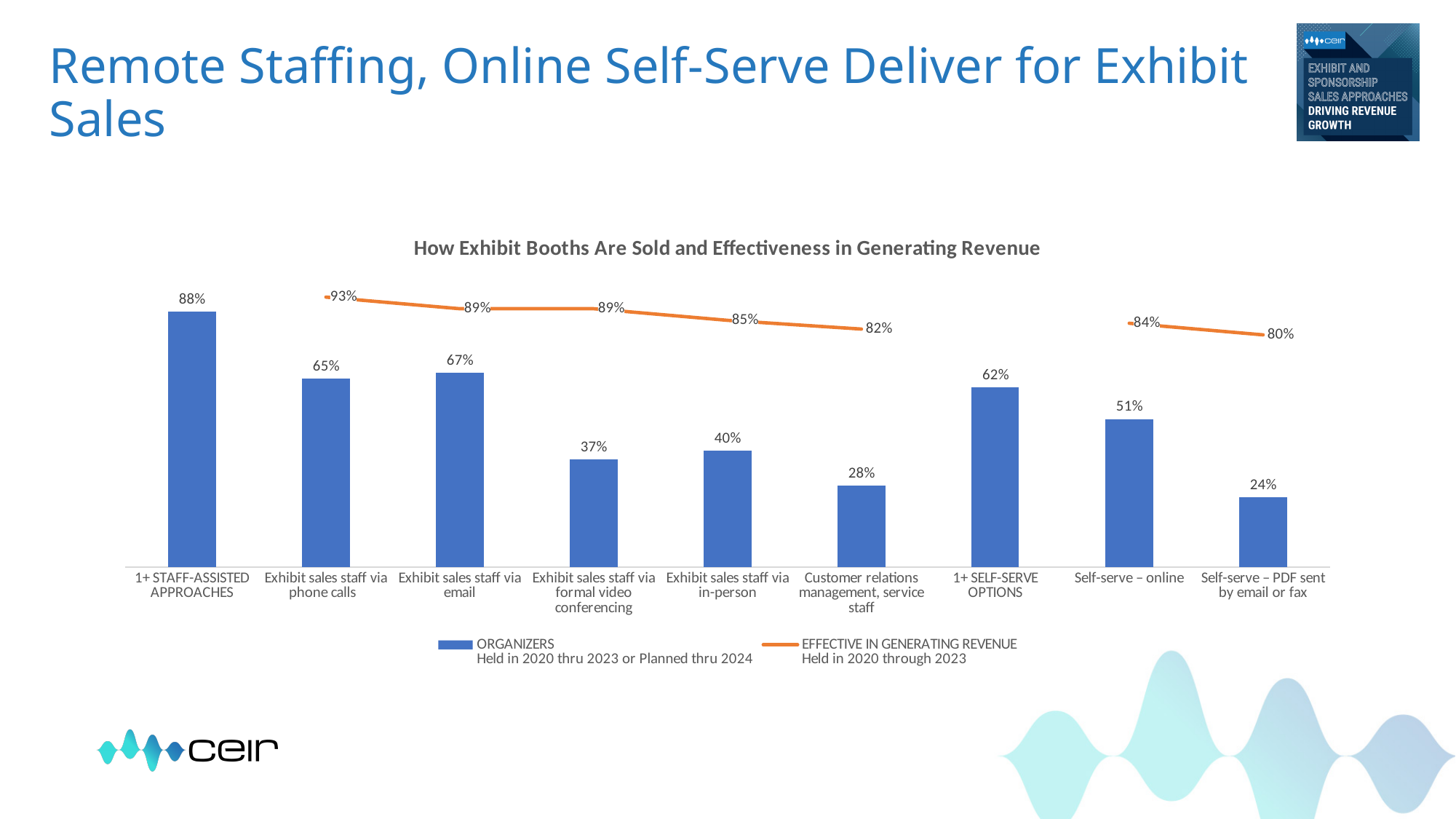
How many categories are shown on the x axis? 9 What is the Organizers value for 'Self-serve – PDF sent by email or fax'? 24% Which category has the highest Organizers bar? 1+ STAFF-ASSISTED APPROACHES Which category has the lowest Organizers bar? Self-serve – PDF sent by email or fax What is the Organizers value for 'Exhibit sales staff via email'? 67% What kind of chart is this? Combined bar and line chart What is the title of the chart? How Exhibit Booths Are Sold and Effectiveness in Generating Revenue What is the 'Effective in generating revenue' value for 'Exhibit sales staff via phone calls'? 93% Which has a larger Organizers value: 'Exhibit sales staff via in-person' or 'Customer relations management, service staff'? Exhibit sales staff via in-person Which category has the lowest 'Effective in generating revenue' value on the line? Self-serve – PDF sent by email or fax What is the difference between the Organizers values for 'Self-serve – online' and 'Self-serve – PDF sent by email or fax'? 27% How many series does the legend list? 2